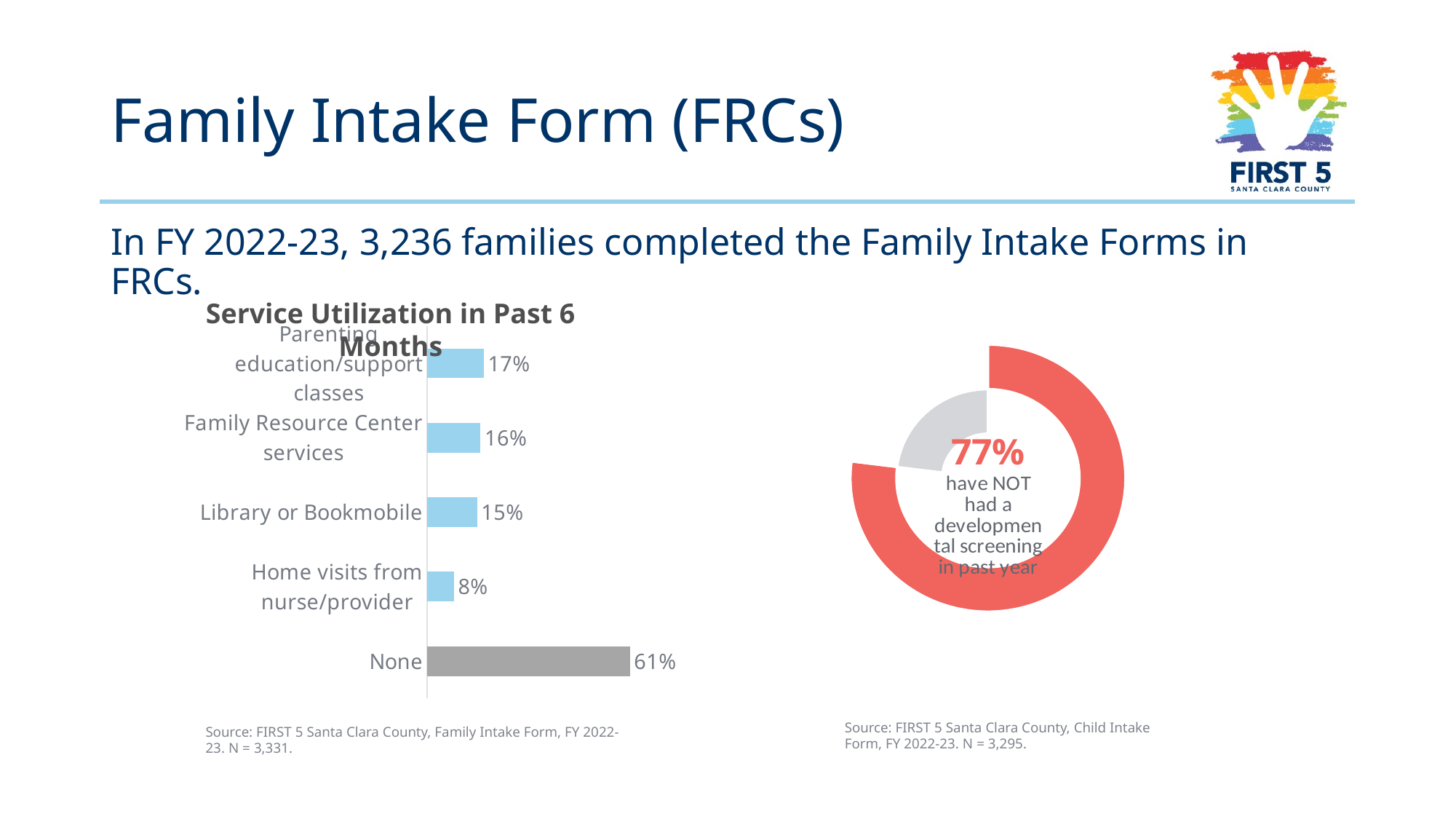
In the donut chart on the right, what percentage have NOT had a developmental screening in the past year? 77% What kind of chart is shown on the right side of the slide? Donut chart In the 'Service Utilization in Past 6 Months' chart, what is the value for Home visits from nurse/provider? 8% In the 'Service Utilization in Past 6 Months' chart, what is the difference between the value for None and the value for Parenting education/support classes? 44% In the 'Service Utilization in Past 6 Months' chart, which category has the lowest value? Home visits from nurse/provider In the 'Service Utilization in Past 6 Months' chart, what is the value for Library or Bookmobile? 15% What kind of chart is the 'Service Utilization in Past 6 Months' chart? Bar chart In the 'Service Utilization in Past 6 Months' chart, which category has the highest value? None In the 'Service Utilization in Past 6 Months' chart, what is the value for Family Resource Center services? 16% In the 'Service Utilization in Past 6 Months' chart, which bar is coloured grey rather than light blue? None How many categories are shown in the 'Service Utilization in Past 6 Months' chart? 5 In the 'Service Utilization in Past 6 Months' chart, which is larger: Library or Bookmobile or Home visits from nurse/provider? Library or Bookmobile